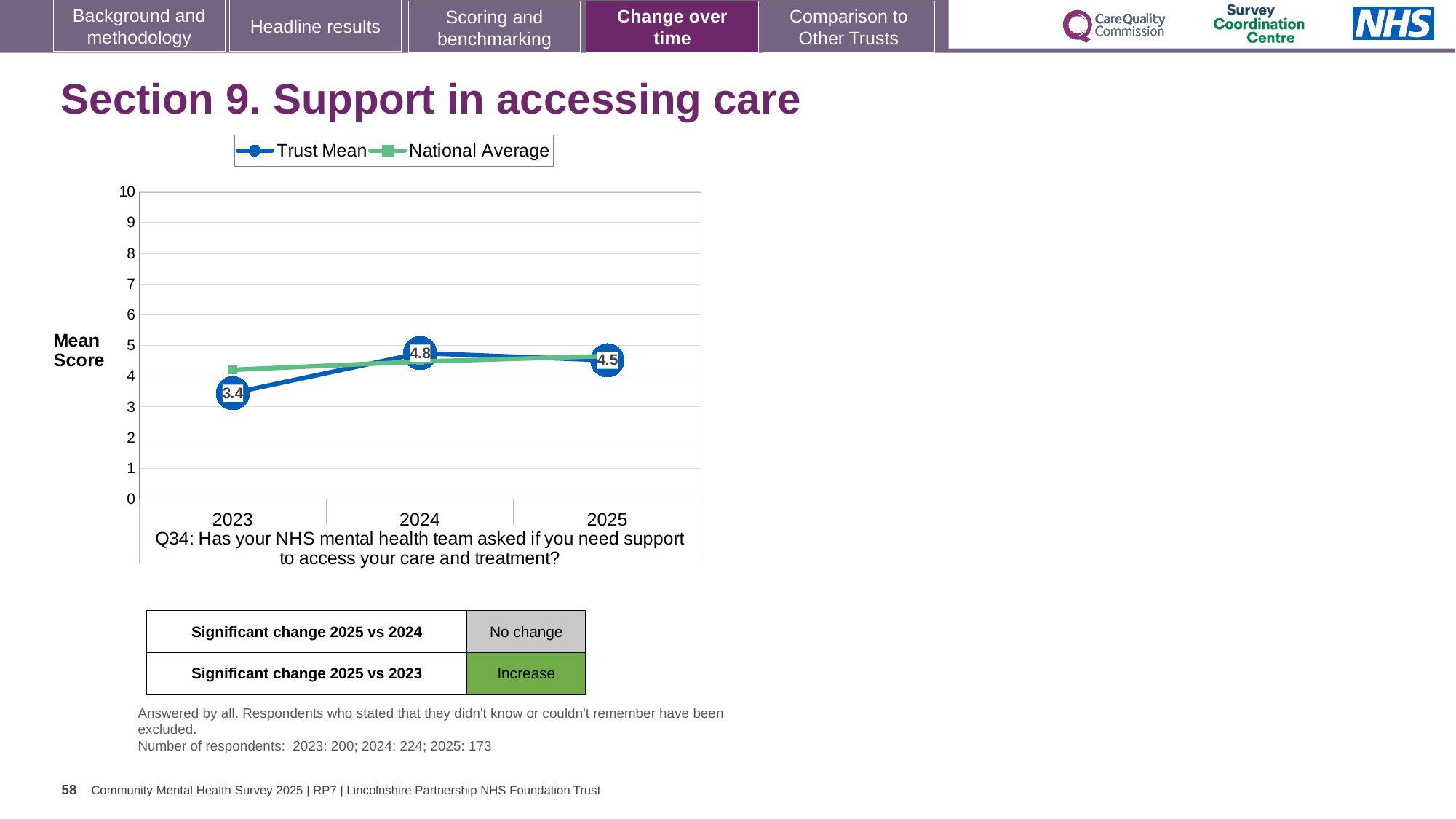
In which year is the Trust Mean highest? 2024 How many years are plotted on the x axis? 3 What is the difference between the Trust Mean in 2024 and in 2023? 1.4 Which is larger, the Trust Mean in 2025 or in 2023? 2025 What kind of chart is shown on the slide? line chart What is the Trust Mean value for 2024? 4.8 Does the Trust Mean rise or fall from 2023 to 2024? rise In which year is the Trust Mean lowest? 2023 Is the National Average value for 2023 greater or less than 5? less How many series does the legend list? 2 What is the Trust Mean value for 2025? 4.5 What is the Trust Mean value for 2023? 3.4